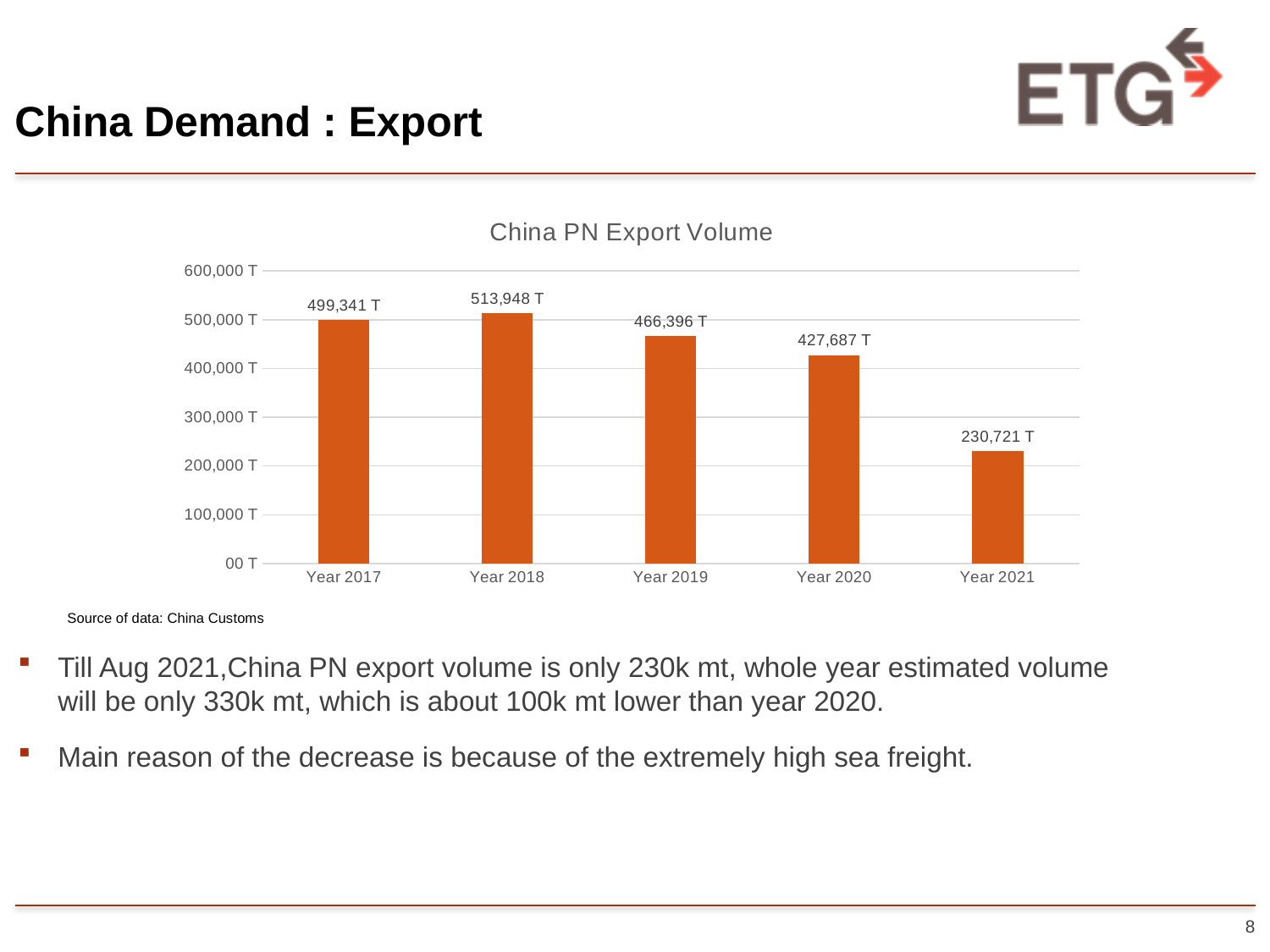
What is the difference in export volume between Year 2018 and Year 2017? 14,607 T What type of chart is used to show China PN Export Volume? Bar chart Which is larger, the export volume for Year 2019 or Year 2020? Year 2019 Is the export volume for Year 2020 greater or less than 400,000 T? greater What is the title of the chart? China PN Export Volume What is the difference in export volume between Year 2020 and Year 2021? 196,966 T What is the China PN export volume for Year 2017? 499,341 T How many years are shown in the chart? 5 Which year has the highest China PN export volume? Year 2018 Which year has the lowest China PN export volume? Year 2021 What is the China PN export volume for Year 2021? 230,721 T What is the China PN export volume for Year 2019? 466,396 T